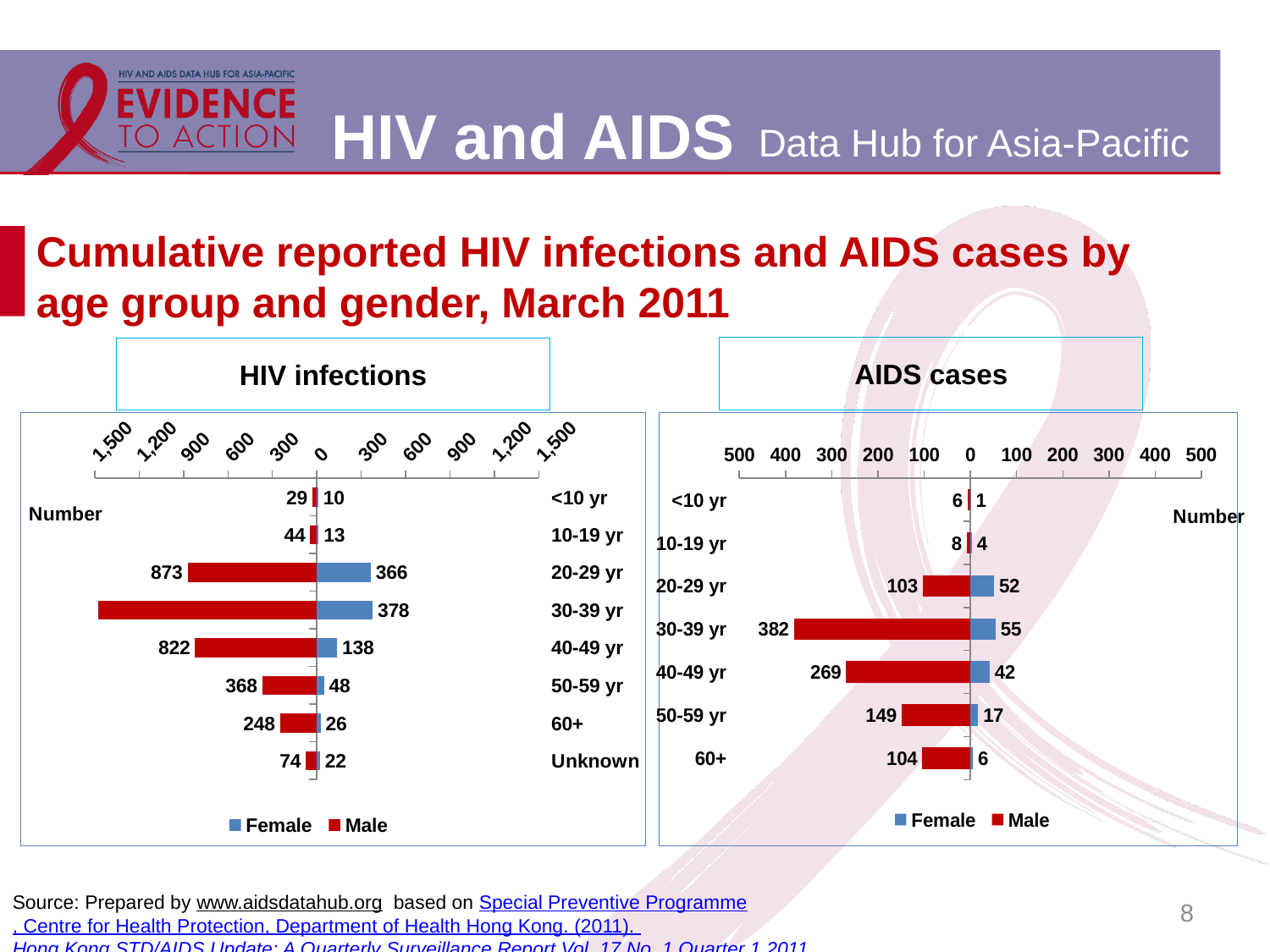
In the HIV infections chart, is the male value for the 30-39 yr age group greater or less than 1,200? greater In the HIV infections chart, what is the combined total of male and female values for the 60+ age group? 274 In the AIDS cases chart, which is larger: the male value for 50-59 yr or the male value for 60+? 50-59 yr In the AIDS cases chart, which age group has the lowest female value? <10 yr In the AIDS cases chart, what is the value for females in the 20-29 yr age group? 52 In the HIV infections chart, what is the value for females in the 30-39 yr age group? 378 How many age group categories does the AIDS cases chart show? 7 In the AIDS cases chart, what is the difference between the male and female values for the 40-49 yr age group? 227 In the AIDS cases chart, what is the value for males in the 30-39 yr age group? 382 In the AIDS cases chart, which age group has the highest male value? 30-39 yr What kind of chart is the AIDS cases chart? bar chart In the HIV infections chart, what is the value for males in the 20-29 yr age group? 873